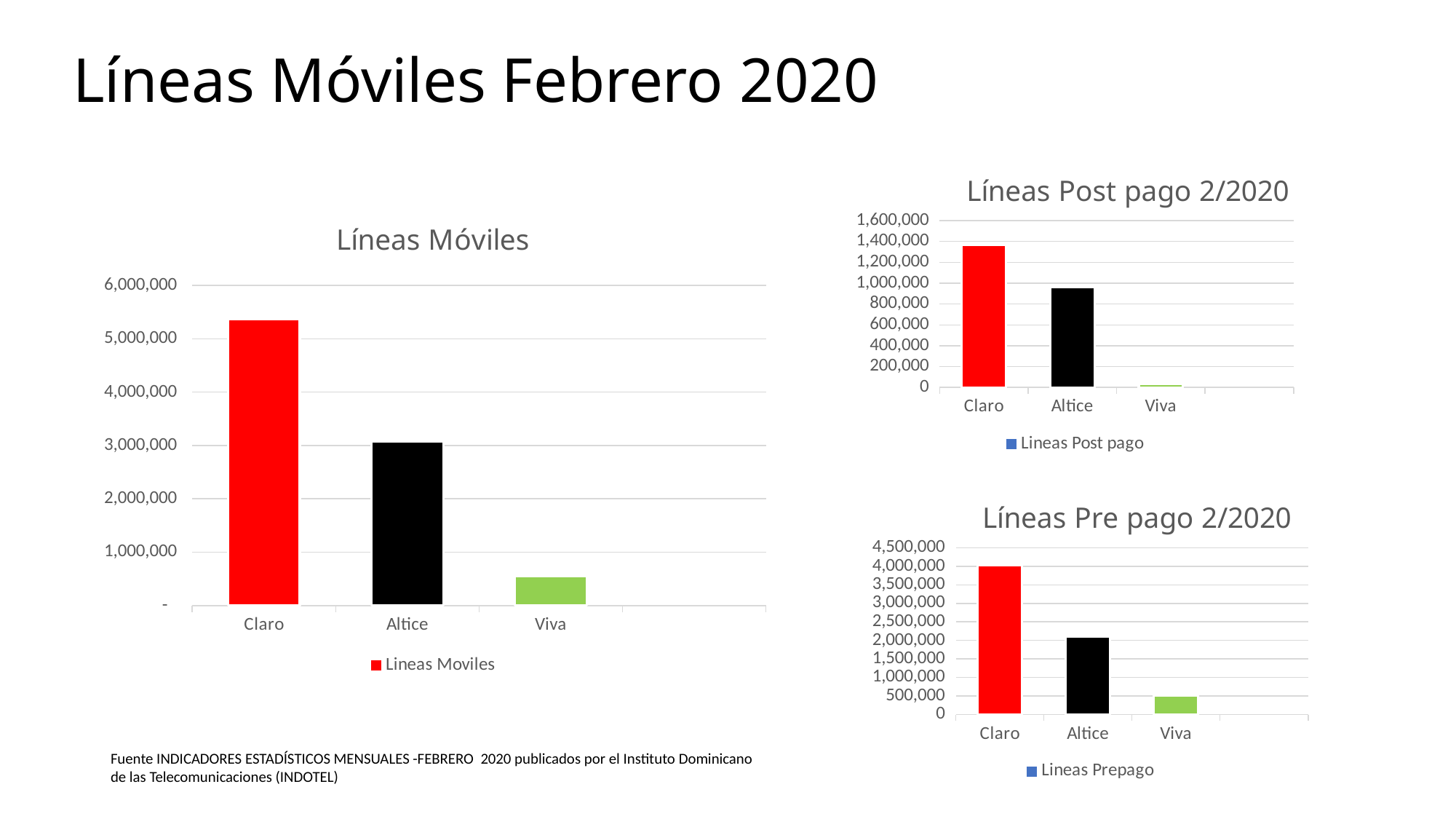
In the "Líneas Móviles" chart, which category has the lowest value? Viva How many categories are shown in the "Líneas Móviles" chart? 3 In the "Líneas Móviles" chart, is the value for Viva greater or less than 1,000,000? less In the "Líneas Móviles" chart, which category has the highest value? Claro In the "Líneas Pre pago 2/2020" chart, which is larger, the value for Claro or the value for Altice? Claro In the "Líneas Post pago 2/2020" chart, which category has the lowest value? Viva In the "Líneas Post pago 2/2020" chart, is the value for Altice greater or less than 800,000? greater In the "Líneas Móviles" chart, is the value for Claro greater or less than 5,000,000? greater How many series does the legend of the "Líneas Pre pago 2/2020" chart list? 1 What kind of chart is the "Líneas Móviles" chart on the left? bar chart